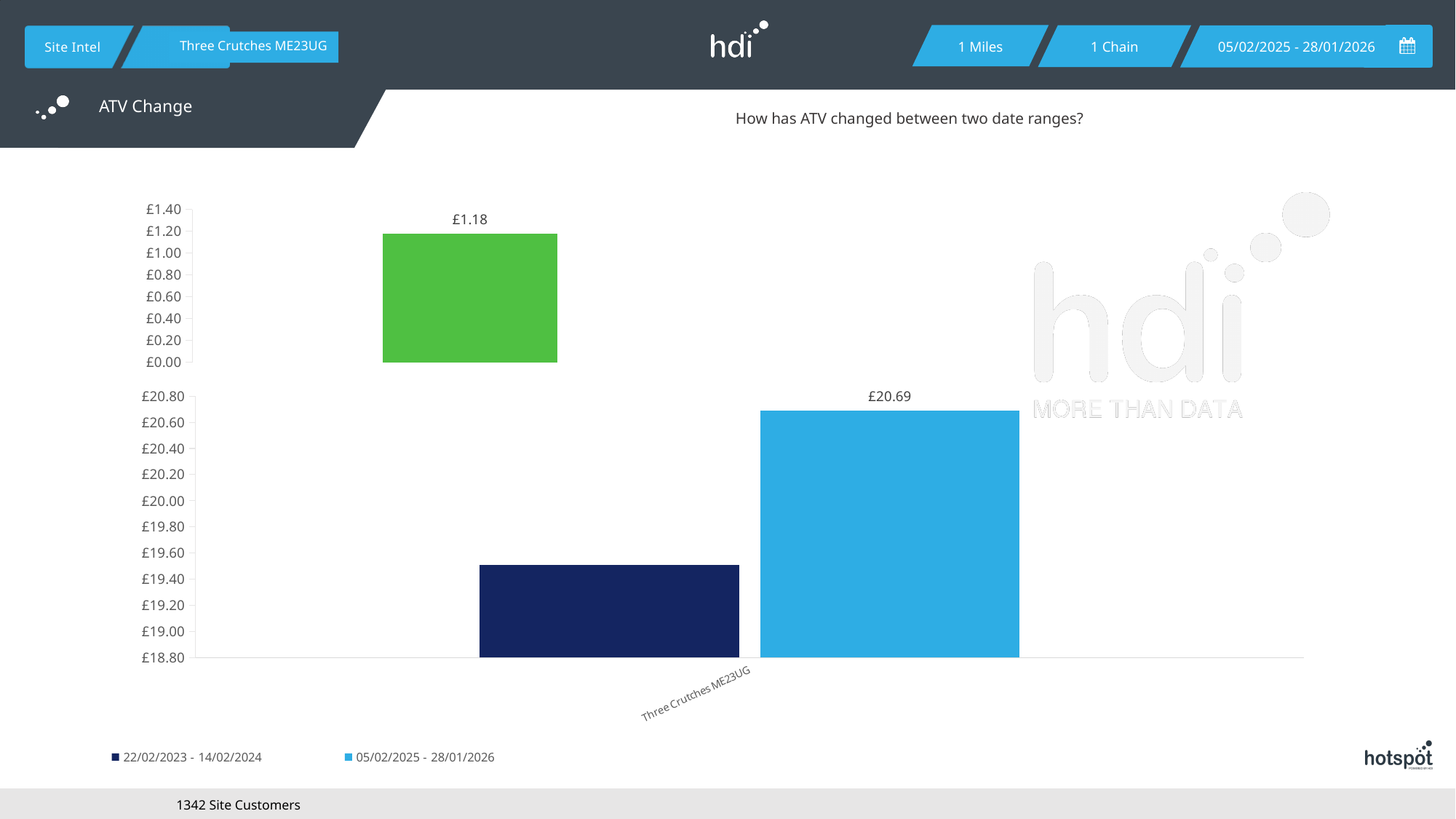
How many series does the legend at the bottom of the slide list? 2 What kind of chart is the bottom chart? bar chart In the top chart, what value is printed above the green bar? £1.18 What is the category label shown on the x axis of the bottom chart? Three Crutches ME23UG In the top chart, is the value of the green bar greater or less than £1.00? greater How many bars are plotted in the bottom chart? 2 What colour is the bar for the 05/02/2025 - 28/01/2026 series in the bottom chart? light blue In the bottom chart, is the value for the 22/02/2023 - 14/02/2024 bar greater or less than £19.40? greater In the bottom chart, what is the value of the 05/02/2025 - 28/01/2026 bar for Three Crutches ME23UG? £20.69 In the bottom chart, which series has the higher value: 22/02/2023 - 14/02/2024 or 05/02/2025 - 28/01/2026? 05/02/2025 - 28/01/2026 In the bottom chart, is the value for the 22/02/2023 - 14/02/2024 bar greater or less than £20.00? less